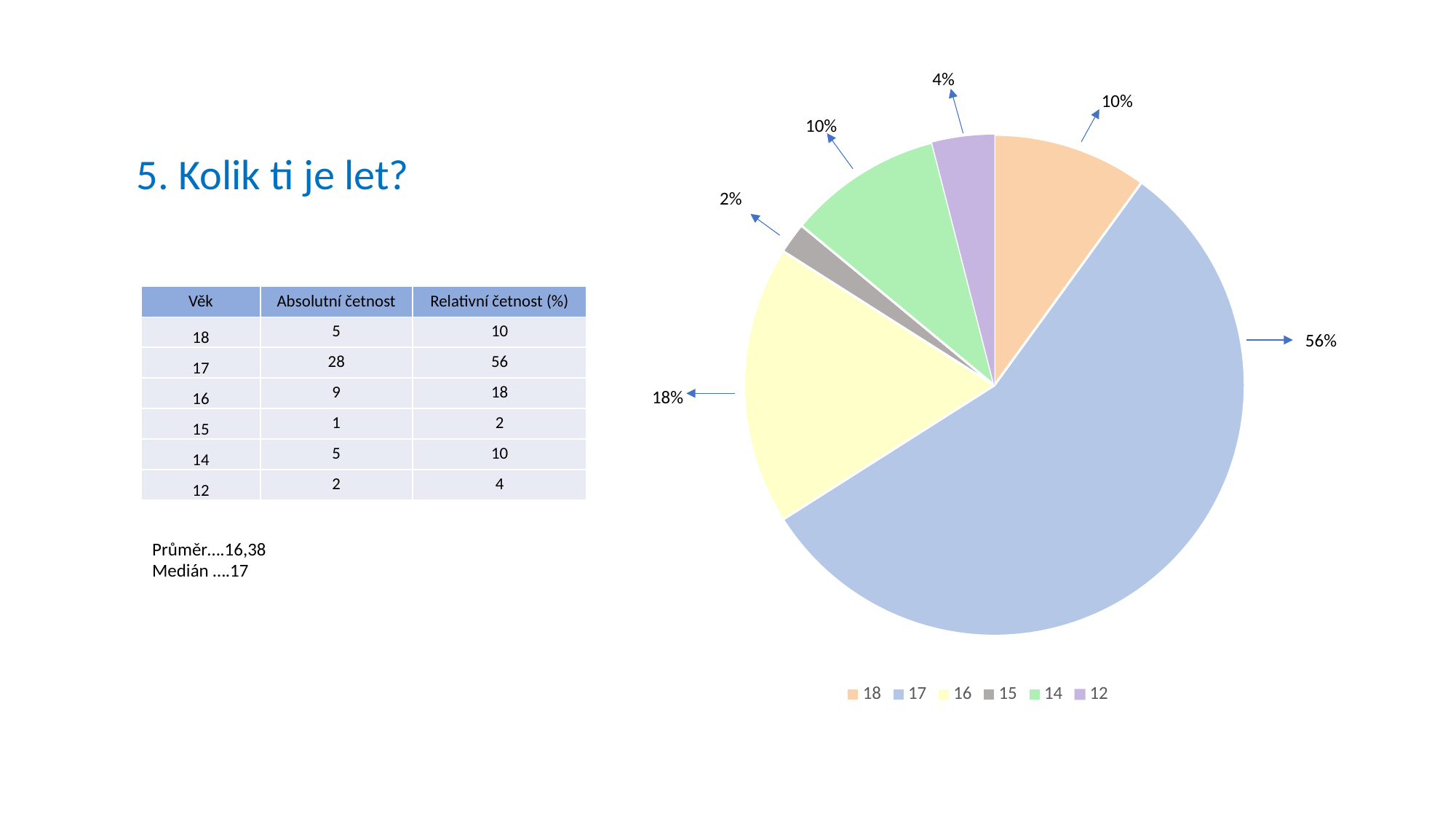
What colour is the slice for age 17 in the pie chart? blue What share of the pie does the slice for age 12 represent? 4% How many entries does the pie chart's legend list? 6 What kind of chart is shown on the slide? pie chart What share of the pie does the slice for age 17 represent? 56% Which age has the largest slice in the pie chart? 17 Which age has the smallest slice in the pie chart? 15 What is the difference in percentage points between the slices for age 17 and age 16? 38 Which slice is larger in the pie chart, age 16 or age 14? 16 What share of the pie does the slice for age 15 represent? 2% How many slices does the pie chart have? 6